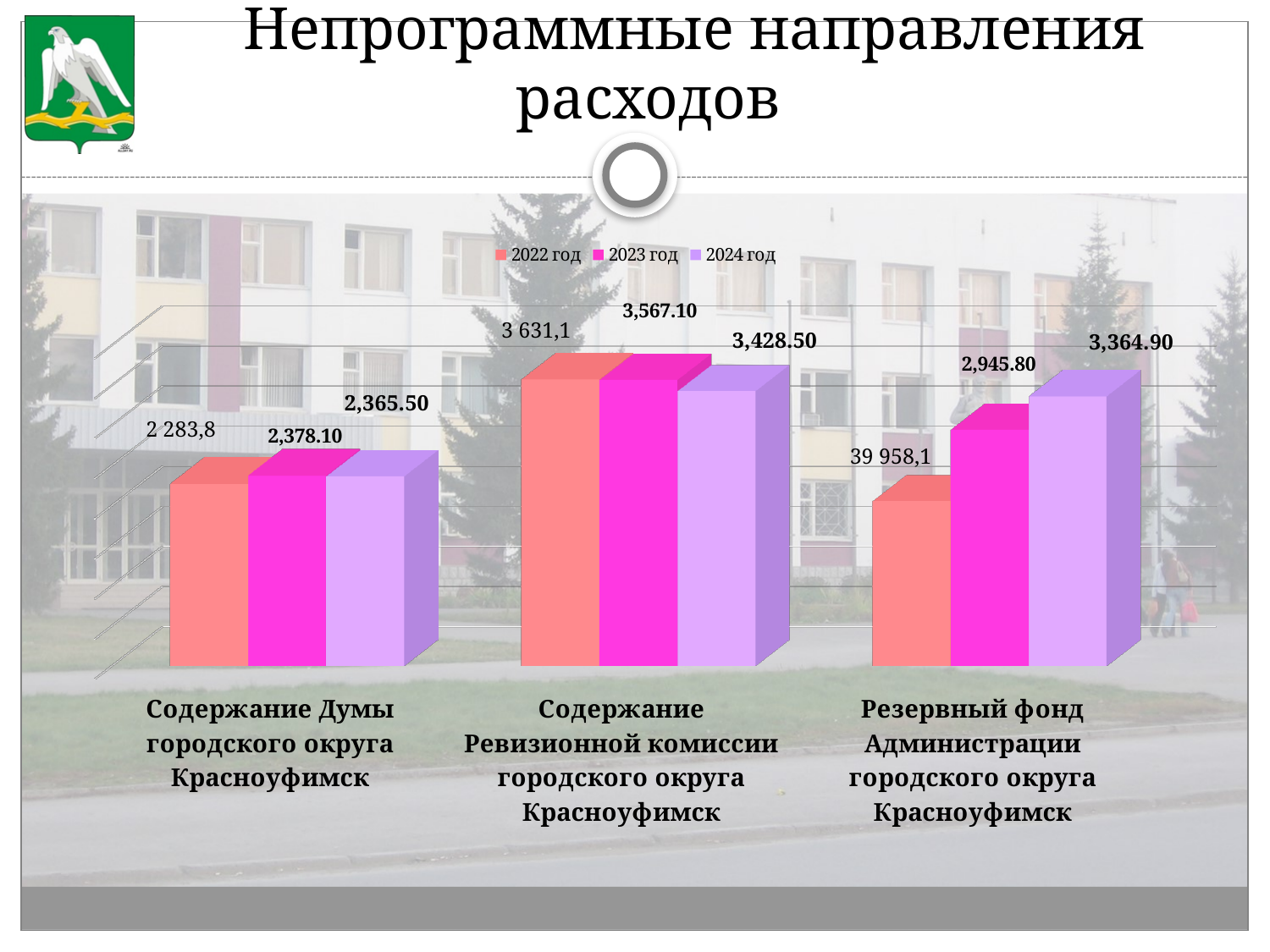
What is the value for 2022 год for Содержание Ревизионной комиссии городского округа Красноуфимск? 3 631,1 Which is larger for Содержание Ревизионной комиссии городского округа Красноуфимск: the 2023 год value or the 2024 год value? 2023 год What type of chart is shown on the slide? bar chart Do the values for Содержание Ревизионной комиссии городского округа Красноуфимск rise or fall from 2022 год to 2024 год? fall What is the value for 2024 год for Резервный фонд Администрации городского округа Красноуфимск? 3,364.90 Which category has the lowest value for 2024 год? Содержание Думы городского округа Красноуфимск Which category has the highest value for 2023 год? Содержание Ревизионной комиссии городского округа Красноуфимск What is the difference between the 2024 год and 2023 год values for Резервный фонд Администрации городского округа Красноуфимск? 419.10 What is the value for 2023 год for Содержание Думы городского округа Красноуфимск? 2,378.10 How many series does the legend list? 3 How many categories are shown on the x axis? 3 What is the value for 2024 год for Содержание Ревизионной комиссии городского округа Красноуфимск? 3,428.50